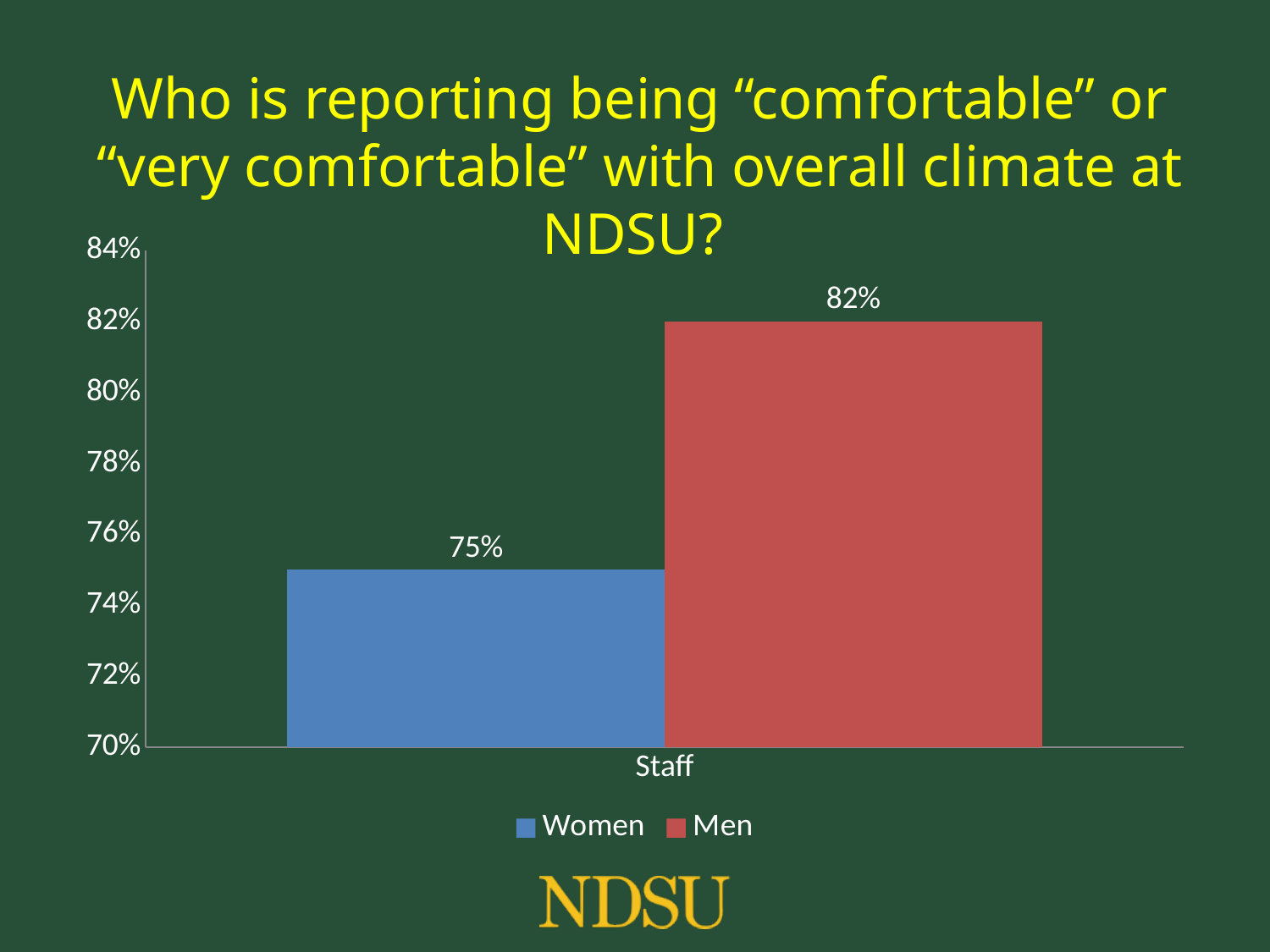
What kind of chart is shown on the slide? bar chart What colour is the bar for Men? red Which series has the higher value for Staff, Women or Men? Men How many categories are shown on the x axis? 1 Which series has the lower value for Staff? Women What percentage of men staff report being comfortable or very comfortable with the overall climate at NDSU? 82% What percentage of women staff report being comfortable or very comfortable with the overall climate at NDSU? 75% Is the value for Men greater or less than 80%? greater Is the value for Women greater or less than 80%? less What is the category label on the x axis? Staff What is the difference in percentage points between the Men and Women values for Staff? 7 How many series does the legend list? 2